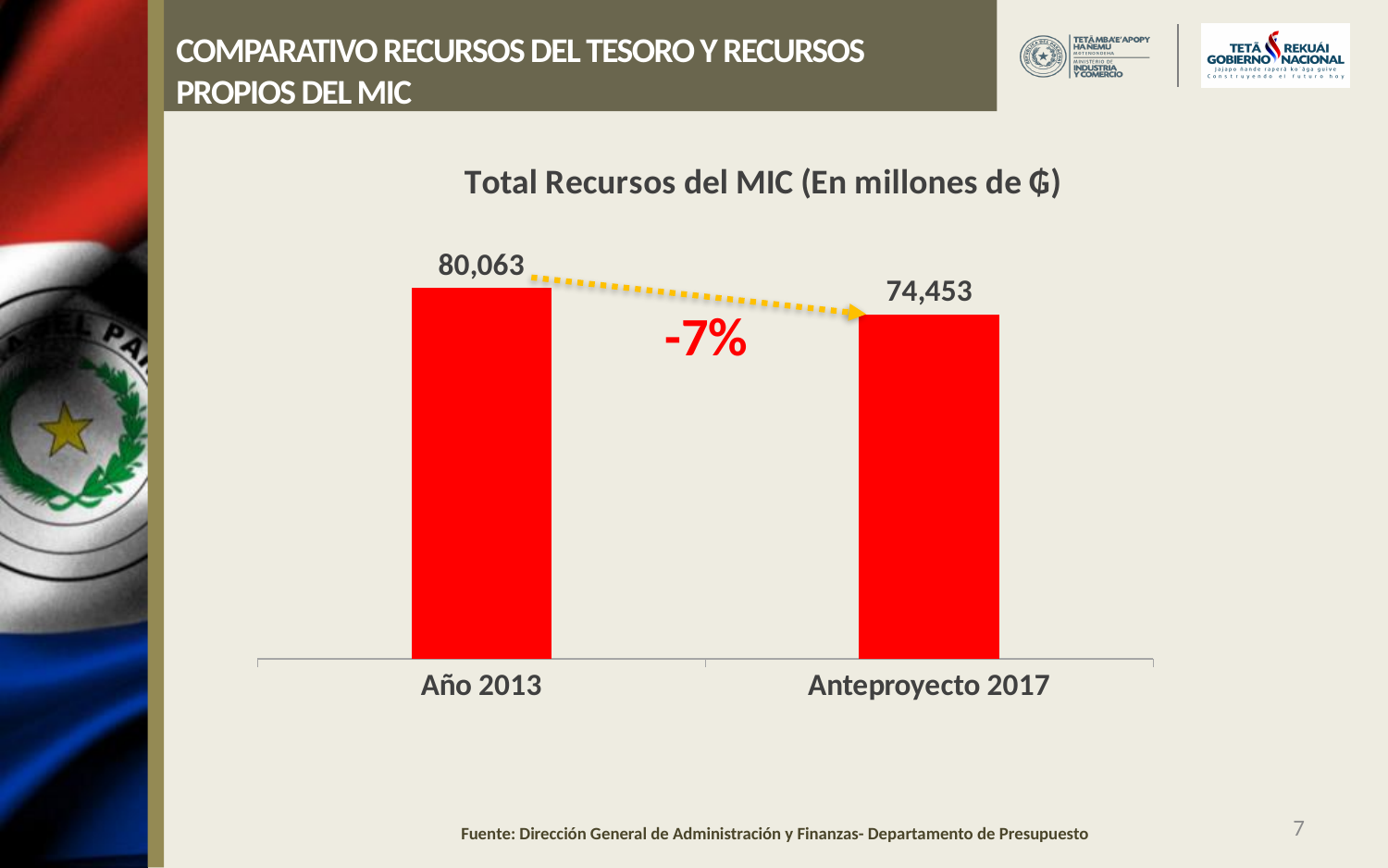
How many categories are shown in the chart? 2 What is the value for Anteproyecto 2017? 74,453 What is the title of the chart? Total Recursos del MIC (En millones de ₲) What kind of chart is shown on the slide? Bar chart What is the difference between the values for Año 2013 and Anteproyecto 2017? 5,610 What is the value for Año 2013? 80,063 Which is larger, the value for Año 2013 or the value for Anteproyecto 2017? Año 2013 Which category has the highest value? Año 2013 Which category has the lowest value? Anteproyecto 2017 Do the values rise or fall from Año 2013 to Anteproyecto 2017? Fall What percentage change is annotated between the two bars? -7%